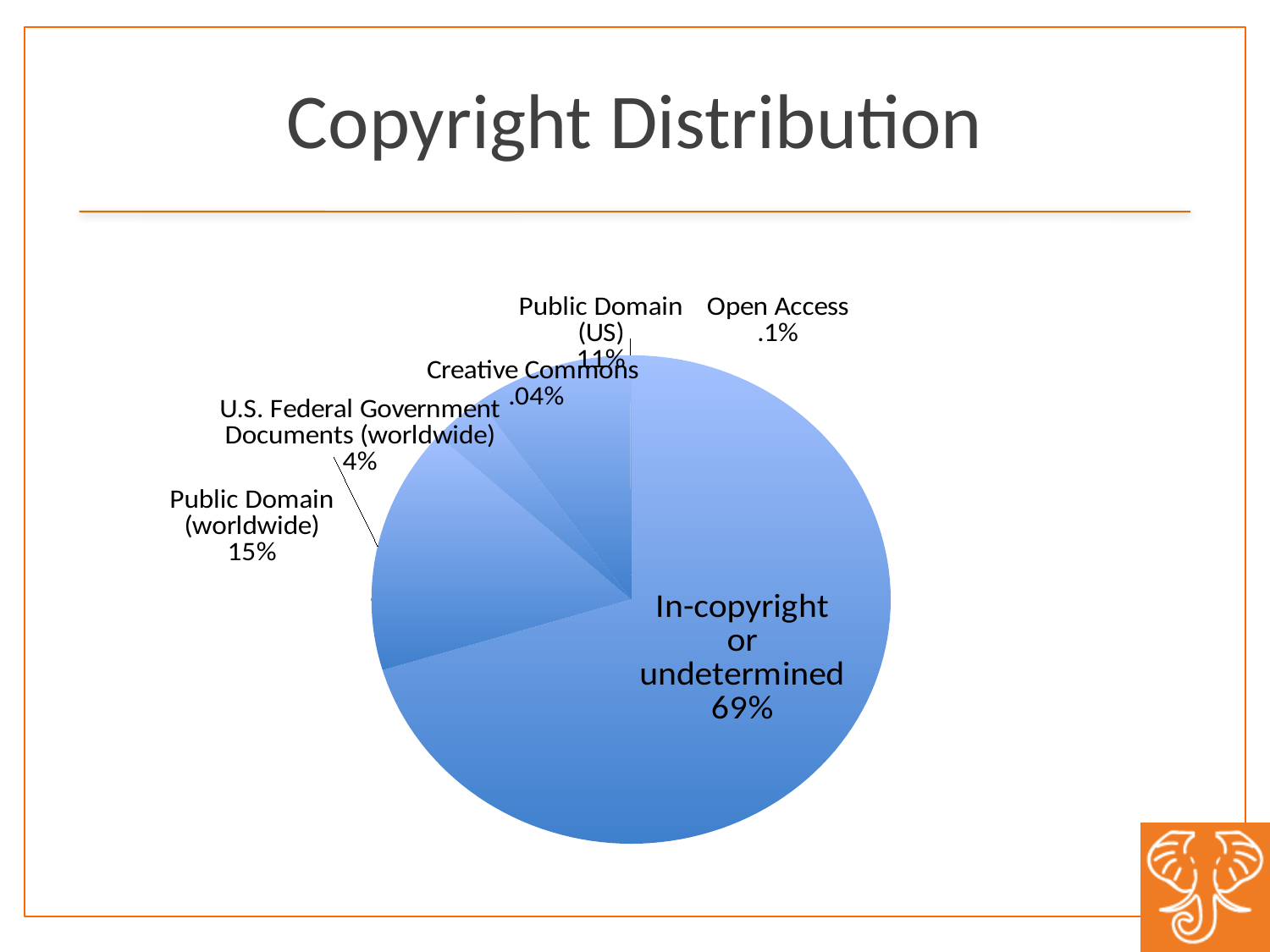
What share of the pie is Creative Commons? .04% What share of the pie is Public Domain (worldwide)? 15% What is the difference in percentage points between In-copyright or undetermined and Public Domain (worldwide)? 54 How many categories are shown in the pie chart? 6 Which category has the smallest slice of the pie? Creative Commons What share of the pie is In-copyright or undetermined? 69% Which category has the largest slice of the pie? In-copyright or undetermined What is the title of the chart? Copyright Distribution What kind of chart is shown on the slide? pie chart Which is larger, Public Domain (worldwide) or U.S. Federal Government Documents (worldwide)? Public Domain (worldwide)